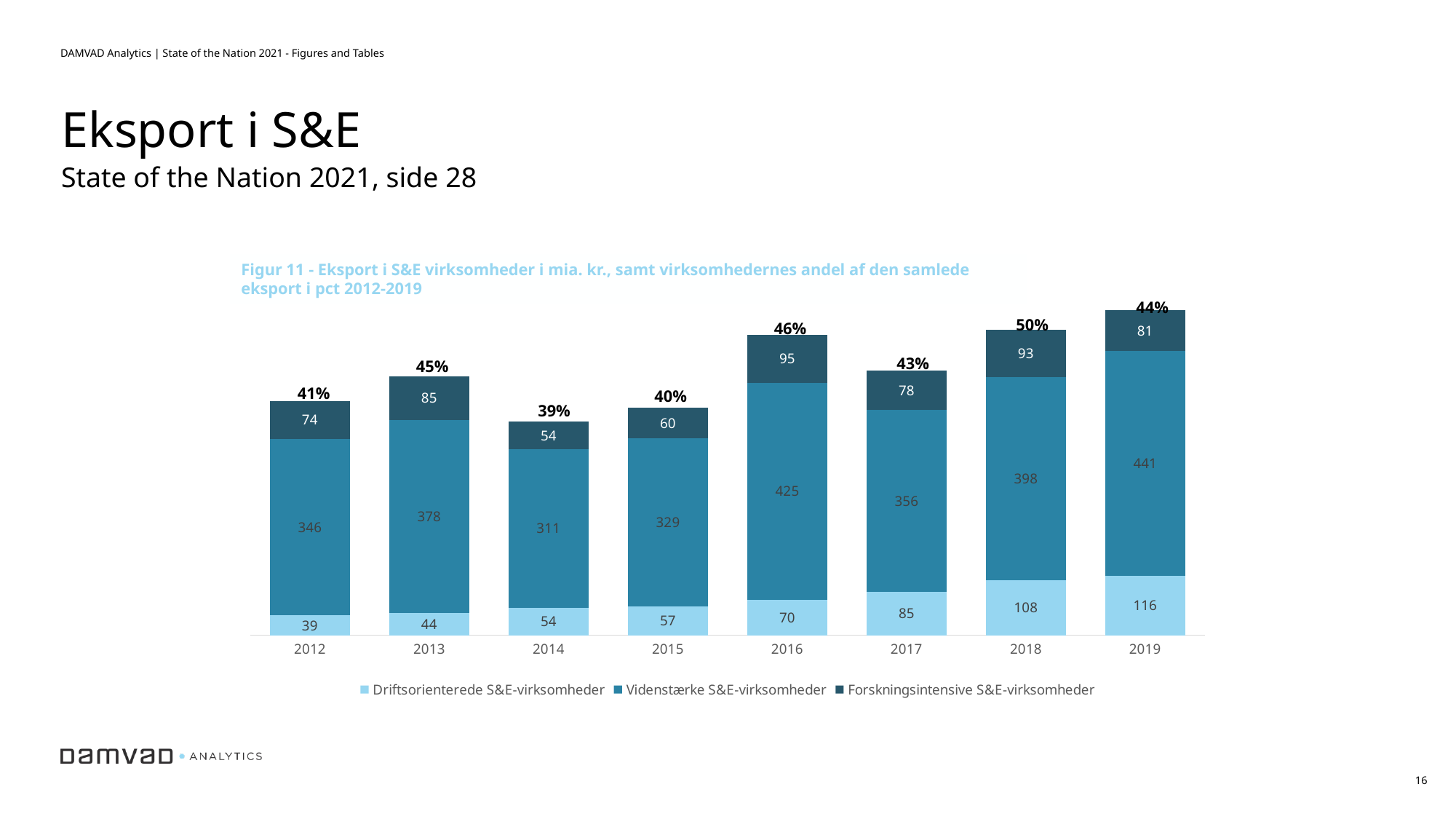
In which year is the value for Forskningsintensive S&E-virksomheder highest? 2016 What is the total of the stacked bar for 2014? 419 What is the total of the stacked bar for 2019? 638 What kind of chart is shown on the slide? Stacked bar chart What is the difference between the Videnstærke S&E-virksomheder values for 2019 and 2012? 95 What is the value for Driftsorienterede S&E-virksomheder in 2018? 108 In which year is the value for Driftsorienterede S&E-virksomheder lowest? 2012 Which is larger, the Forskningsintensive S&E-virksomheder value in 2013 or in 2017? 2013 What is the value for Videnstærke S&E-virksomheder in 2016? 425 How many years are shown on the x axis? 8 How many series does the legend list? 3 What percentage share is shown above the bar for 2018? 50%